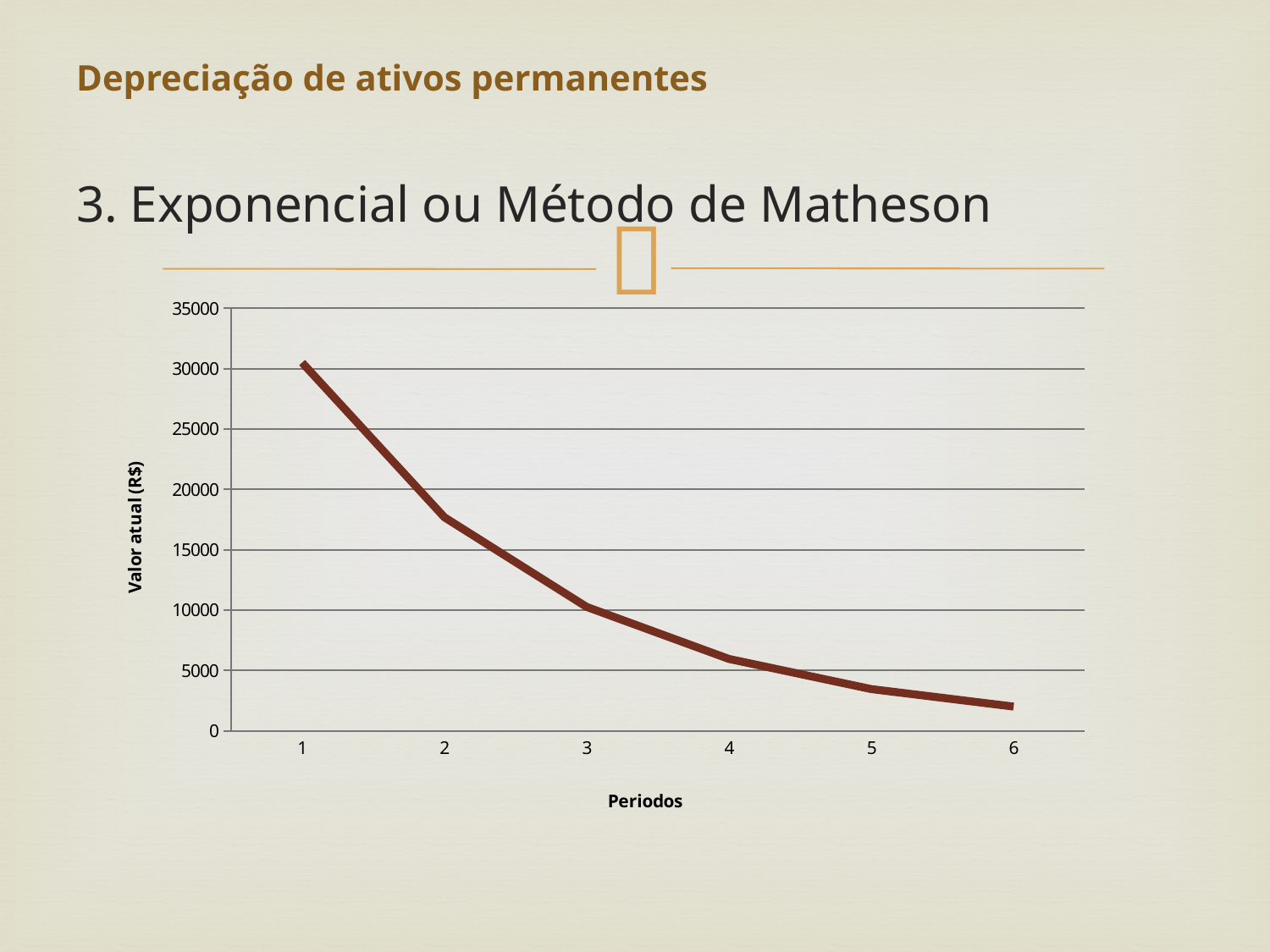
Is the value for period 5 greater or less than 5000? less Is the value for period 2 greater or less than 20000? less Is the value for period 4 greater or less than 10000? less What is the title of the vertical axis of the chart? Valor atual (R$) How many periods are plotted on the x axis of the chart? 6 What kind of chart is shown on the slide? line chart Which is larger, the value for period 2 or the value for period 4? period 2 Do the values rise or fall as the period number increases along the x axis? fall Which period has the highest value on the chart? 1 Which period has the lowest value on the chart? 6